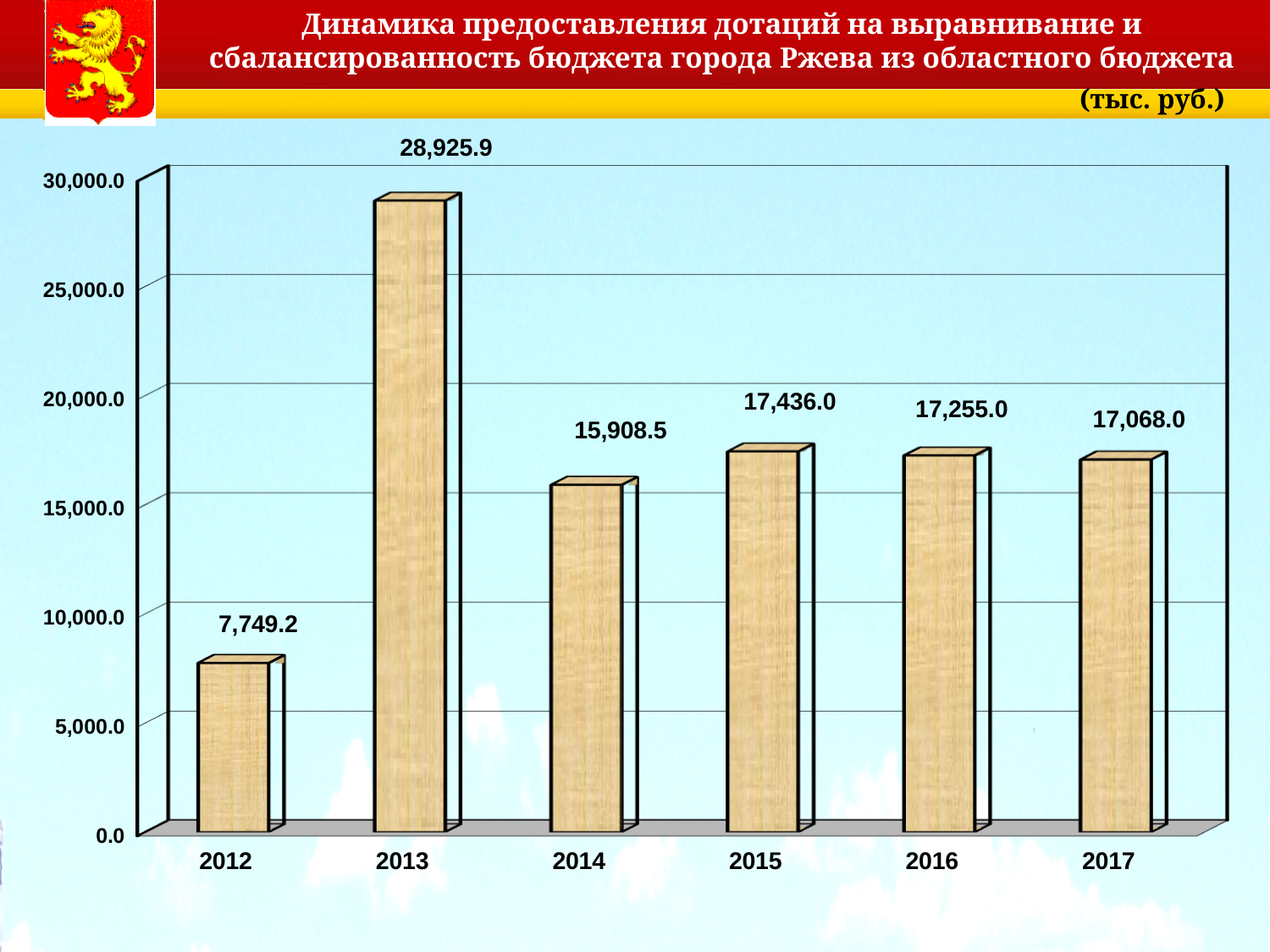
Which is larger, the value for 2014 or the value for 2015? 2015 What kind of chart is shown on the slide? bar chart What is the value for 2016? 17,255.0 Which year has the highest value? 2013 Is the value for 2014 greater or less than 20,000.0? less What is the difference between the values for 2013 and 2012? 21,176.7 How many years are shown on the x axis? 6 What is the value for 2013? 28,925.9 What is the difference between the values for 2015 and 2016? 181.0 What is the value for 2012? 7,749.2 Do the values rise or fall from 2015 to 2017? fall Which year has the lowest value? 2012